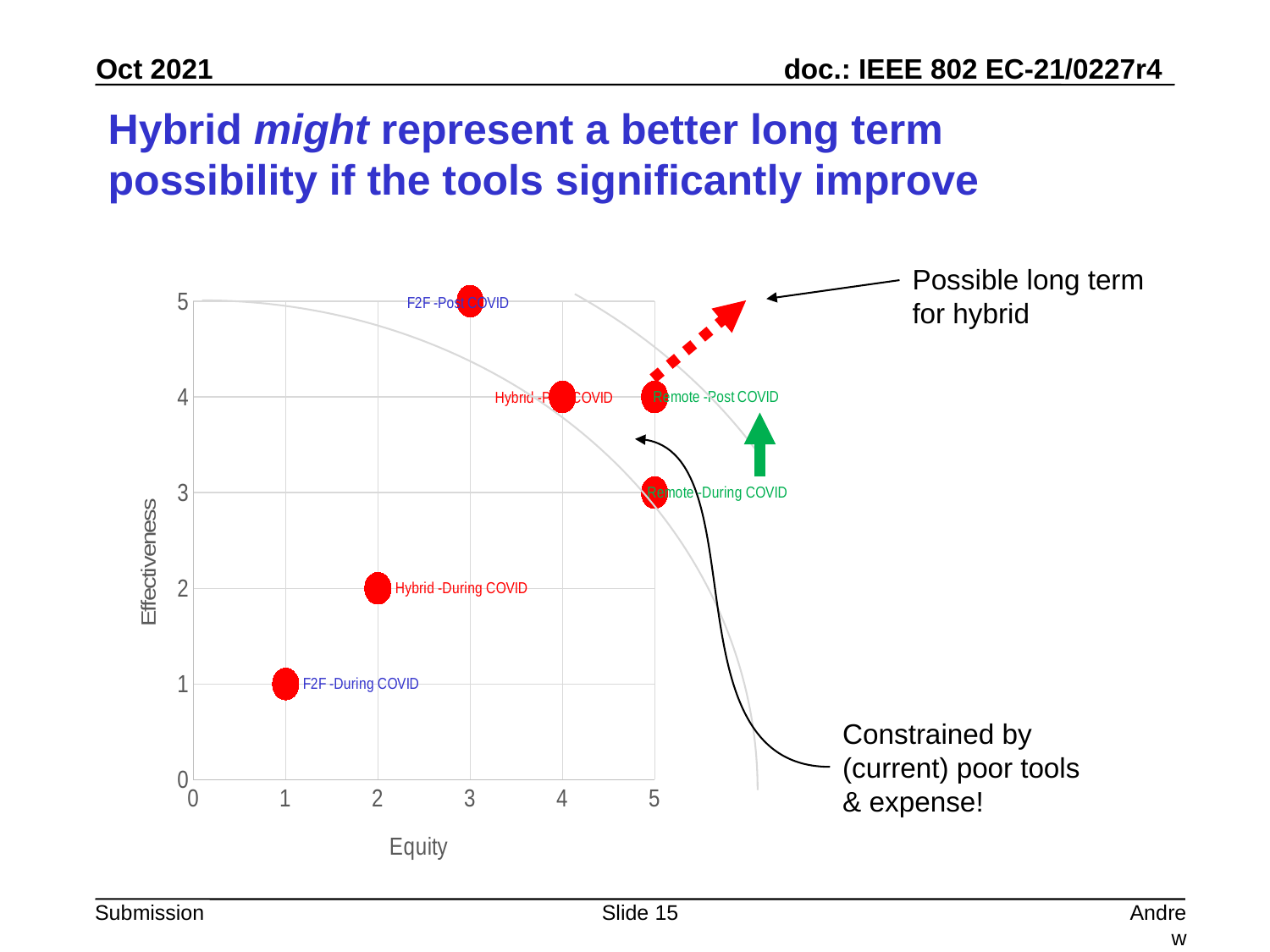
What is the Equity value for Hybrid -During COVID? 2 How many data points are plotted on the chart? 6 What is the label of the vertical axis? Effectiveness Which point has the highest Effectiveness value? F2F -Post COVID What is the label of the horizontal axis? Equity What is the Equity value for F2F -Post COVID? 3 What kind of chart is shown on the slide? Scatter chart Which has the higher Effectiveness value, Hybrid -During COVID or Hybrid -Post COVID? Hybrid -Post COVID Which point has the lowest Equity value? F2F -During COVID What is the difference in Effectiveness between Remote -Post COVID and Remote -During COVID? 1 What is the Effectiveness value for Remote -During COVID? 3 What is the Effectiveness value for F2F -During COVID? 1